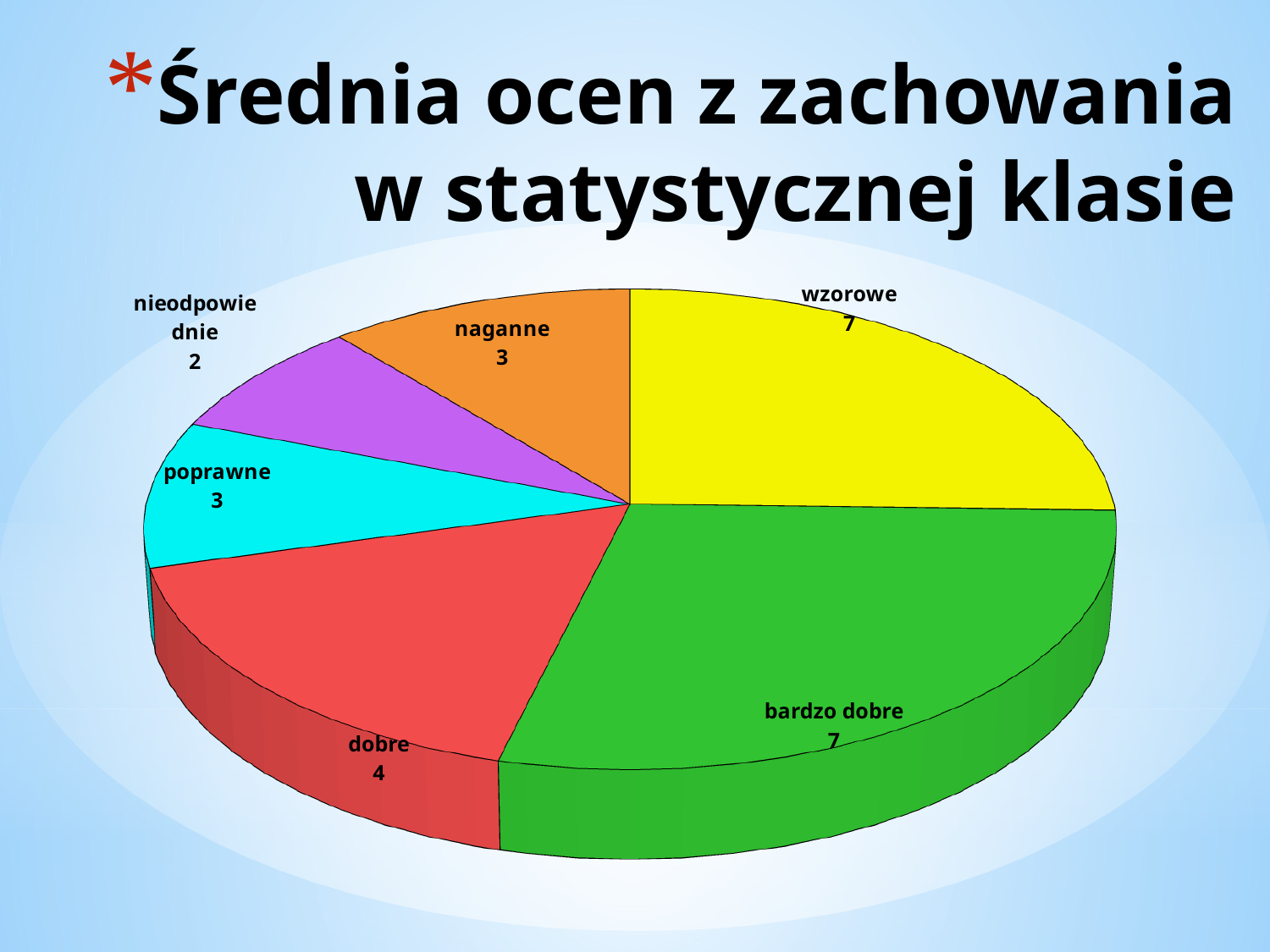
What is the value for the "naganne" slice? 3 How many slices does the pie chart have? 6 What is the difference between the values for "wzorowe" and "nieodpowiednie"? 5 What kind of chart is shown on the slide? pie chart What is the difference between the values for "bardzo dobre" and "dobre"? 3 What is the value for the "nieodpowiednie" slice? 2 What is the value for the "wzorowe" slice? 7 What colour is the "bardzo dobre" slice? green What is the value for the "dobre" slice? 4 Which is larger, the value for "dobre" or the value for "nieodpowiednie"? dobre Which category has the smallest slice? nieodpowiednie What is the value for the "poprawne" slice? 3